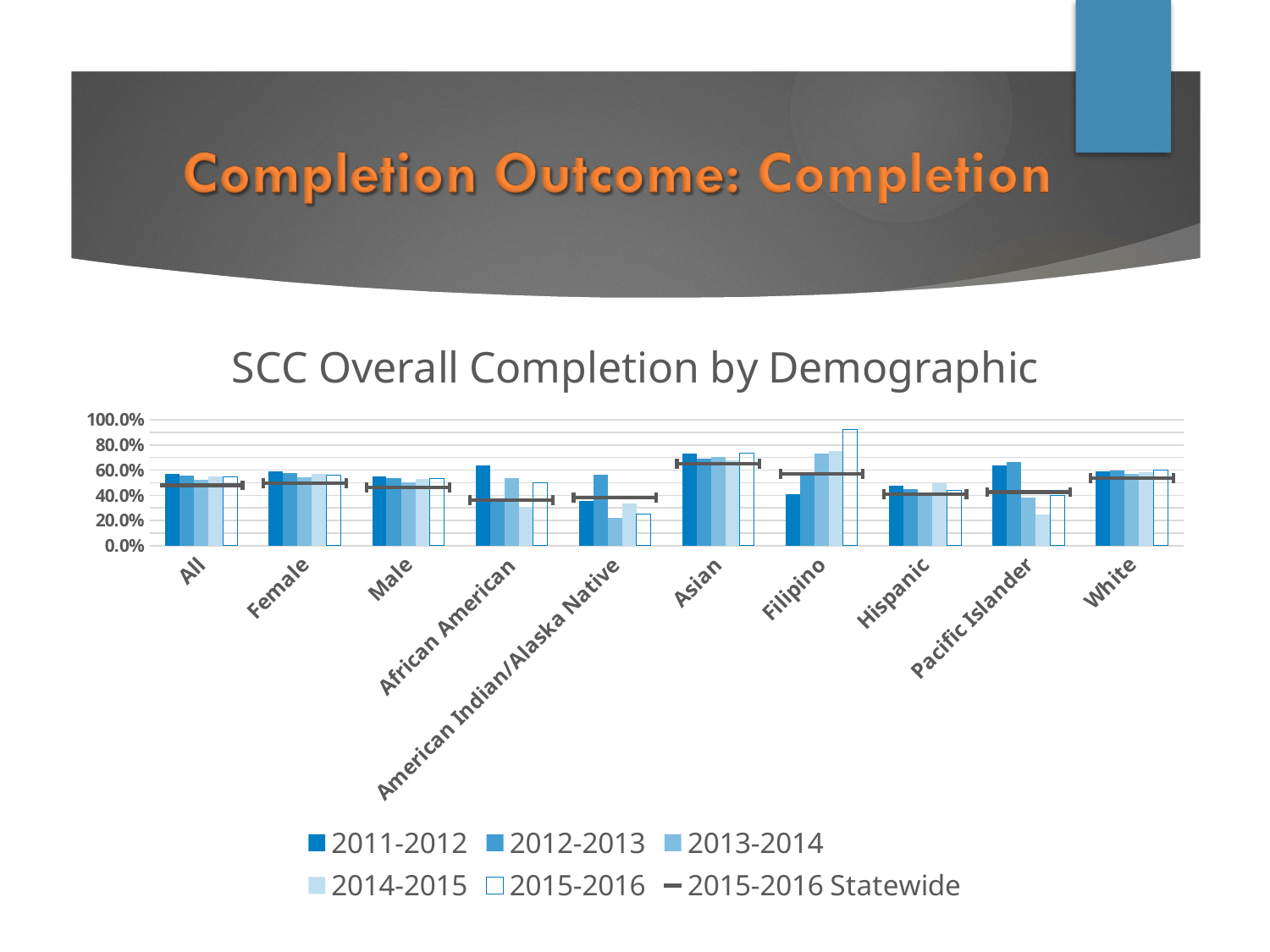
Which category has the lowest 2013-2014 bar? American Indian/Alaska Native Which category has the highest 2015-2016 bar? Filipino Is the 2011-2012 value for Asian greater or less than 60.0%? greater What is the title of the chart? SCC Overall Completion by Demographic Do the Filipino bars rise or fall from 2011-2012 to 2015-2016? rise What kind of chart is shown on the slide? bar chart Is the 2013-2014 value for American Indian/Alaska Native greater or less than 40.0%? less How many demographic categories are shown on the x axis? 10 How many entries does the legend list? 6 Is the 2014-2015 value for Pacific Islander greater or less than 40.0%? less Which is larger for Filipino: the 2011-2012 bar or the 2015-2016 bar? 2015-2016